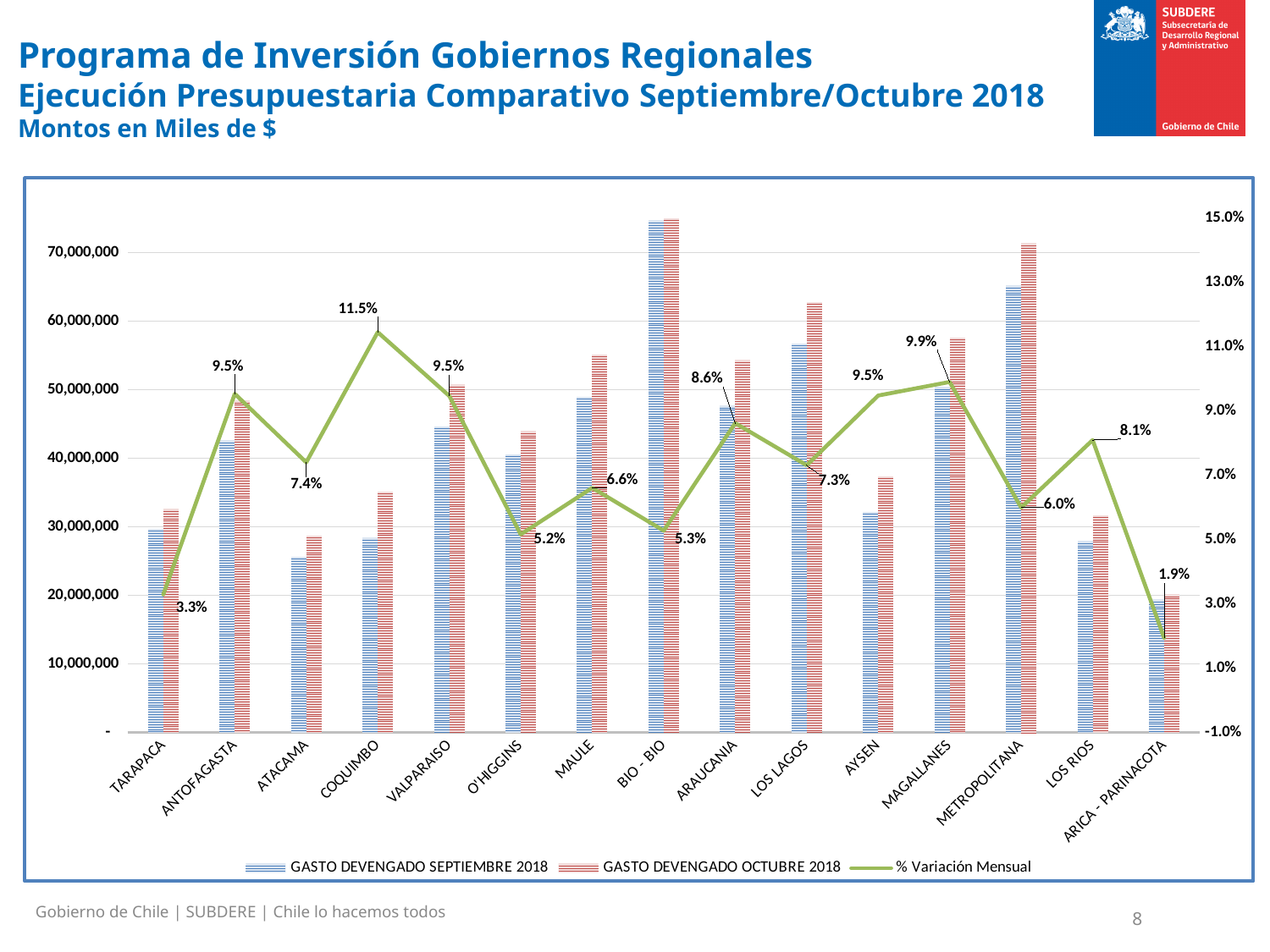
What is the % Variación Mensual value for ARICA - PARINACOTA? 1.9% How many series does the chart legend list? 3 Which region has the highest % Variación Mensual? COQUIMBO What is the difference in percentage points between the % Variación Mensual of COQUIMBO and ARICA - PARINACOTA? 9.6 percentage points Which region has the lowest % Variación Mensual? ARICA - PARINACOTA Which has a higher % Variación Mensual, ANTOFAGASTA or ATACAMA? ANTOFAGASTA Is the GASTO DEVENGADO SEPTIEMBRE 2018 value for BIO - BIO greater or less than 70,000,000? greater What is the % Variación Mensual value for COQUIMBO? 11.5% What is the % Variación Mensual value for MAGALLANES? 9.9% How many regions are shown on the x axis of the chart? 15 What kind of chart is shown on the slide? Combination bar and line chart Is the GASTO DEVENGADO OCTUBRE 2018 value for ATACAMA greater or less than 30,000,000? less